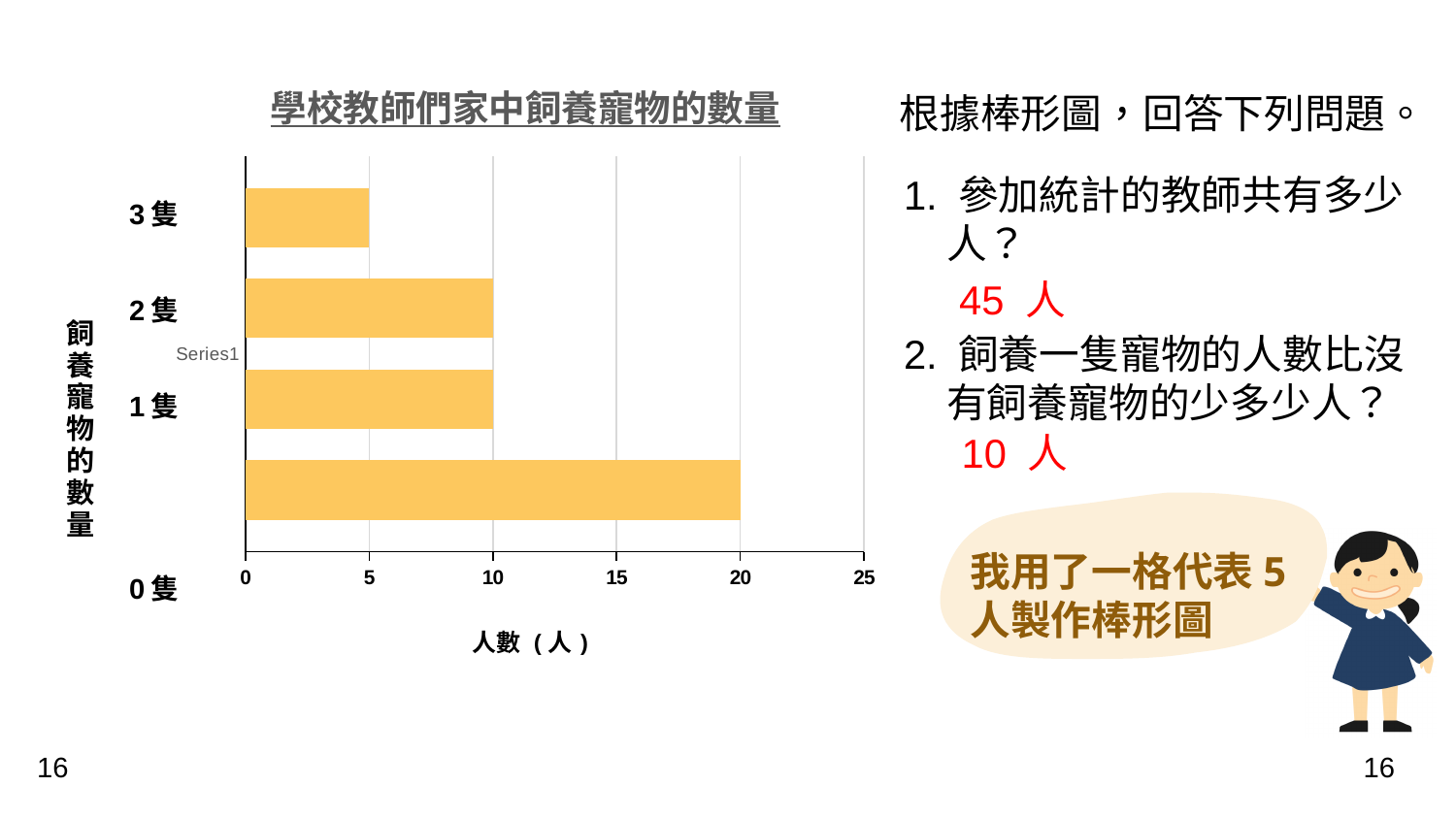
How many categories (numbers of pets) are plotted in the chart? 4 What is the label of the horizontal axis of the chart? 人數（人） Which category has the shortest bar in the chart? 3隻 How many teachers have 3 pets (3隻) according to the chart? 5 What is the title of the chart? 學校教師們家中飼養寵物的數量 What is the difference between the number of teachers with 0 pets (0隻) and those with 1 pet (1隻)? 10 Which category has the longest bar in the chart? 0隻 Which is larger: the value for 2隻 or the value for 3隻? 2隻 What is the total number of teachers across all four categories in the chart? 45 How many teachers have 2 pets (2隻) according to the chart? 10 How many teachers have 0 pets (0隻) according to the chart? 20 What kind of chart is shown on the slide? bar chart